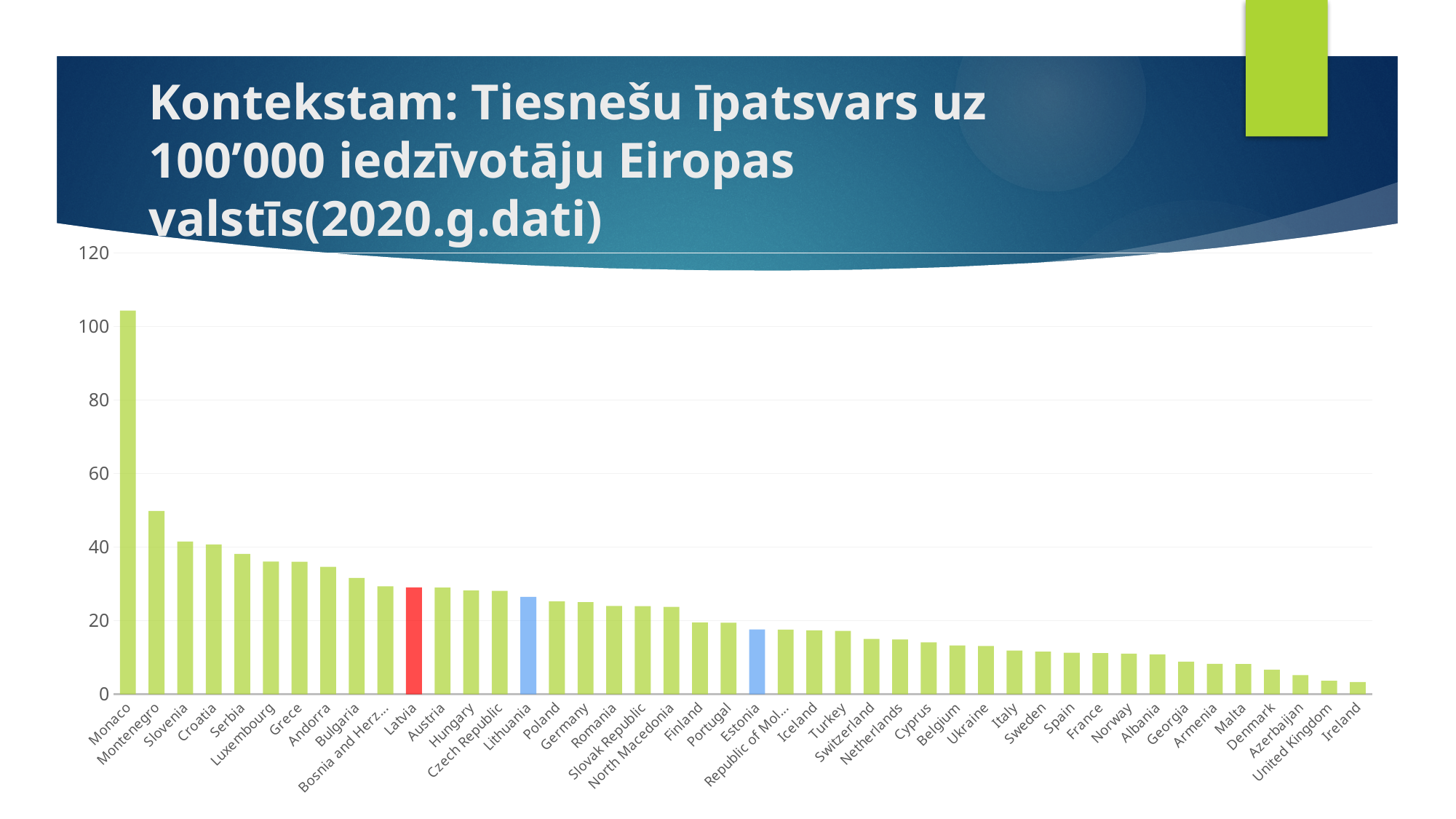
How many countries are shown in the chart? 44 Which has a higher value, Latvia or Estonia? Latvia Is the value for Estonia greater or less than 20? less Is the value for Monaco greater or less than 100? greater Is the value for Ireland greater or less than 20? less Which country's bar is coloured red? Latvia Which country has the highest number of judges per 100,000 inhabitants? Monaco Do the values rise or fall moving from left to right along the x axis? fall Which country has the lowest value in the chart? Ireland What kind of chart is shown on the slide? bar chart